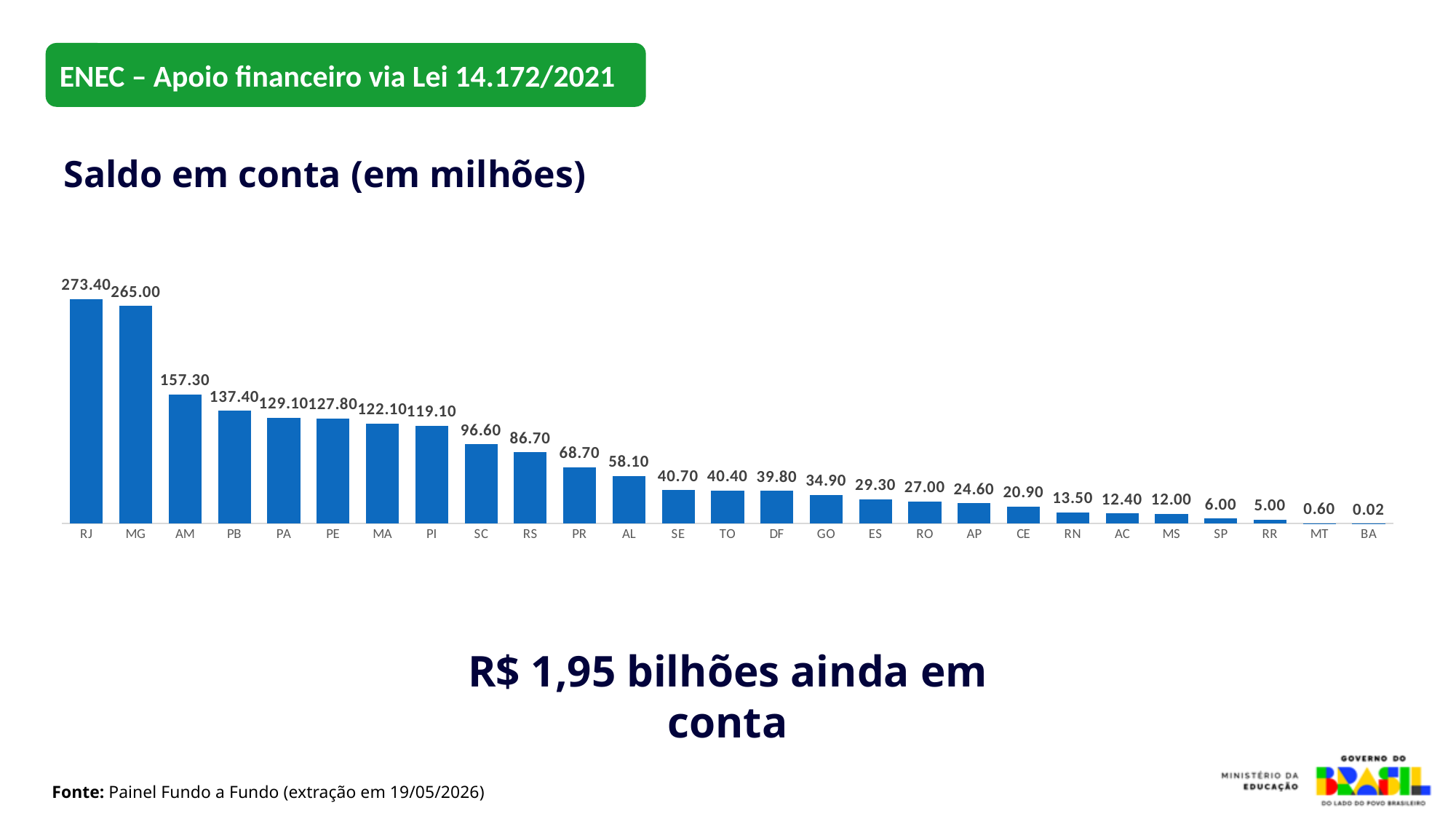
What is the difference between the values for RJ and MG? 8.40 Which state has the highest value in the chart? RJ What is the difference between the values for AM and PB? 19.90 How many states are shown in the chart? 27 What is the title of the chart? Saldo em conta (em milhões) Which state has the lowest value in the chart? BA What kind of chart is shown on the slide? Bar chart What is the value shown for BA in the chart? 0.02 Which has a larger value, PR or AL? PR What is the value shown for GO in the chart? 34.90 What is the value shown for SC in the chart? 96.60 What is the value shown for RJ in the chart? 273.40